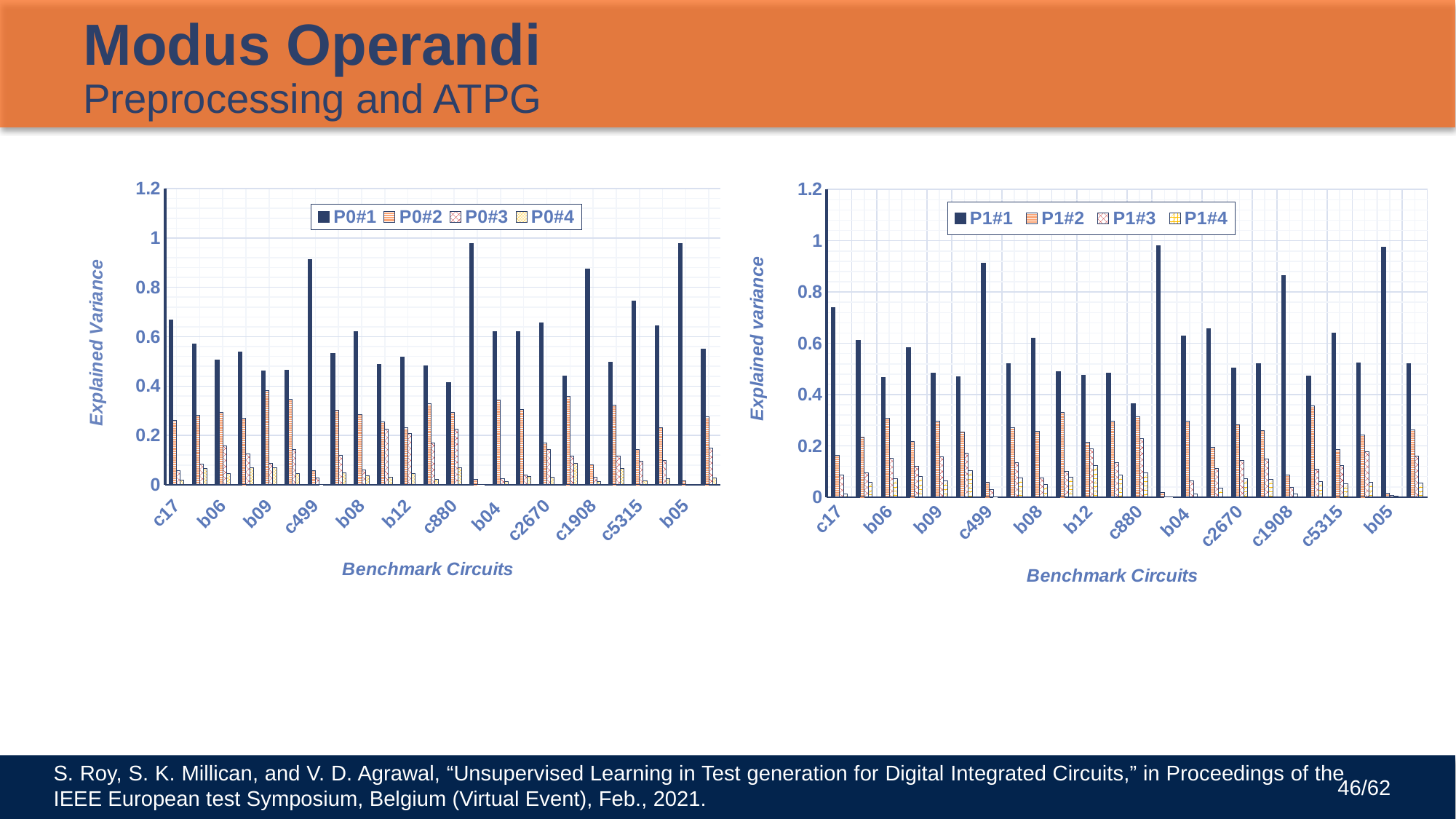
In the left chart, is the tallest P0#1 bar greater or less than 0.8? greater In the right chart, is the value of P1#1 for c17 greater or less than 0.6? greater In the left chart, which series has the tallest bars across the benchmark circuits? P0#1 What kind of chart is the left chart on the slide? bar chart What is the x-axis title of the left chart? Benchmark Circuits How many series does the legend of the right chart list? 4 In the right chart, which series has the shortest bars across the benchmark circuits? P1#4 In the right chart, is the tallest P1#4 bar greater or less than 0.2? less In the left chart, which is larger for c17: the P0#1 bar or the P0#2 bar? P0#1 How many series does the legend of the left chart list? 4 What are the legend entries of the right chart? P1#1, P1#2, P1#3, P1#4